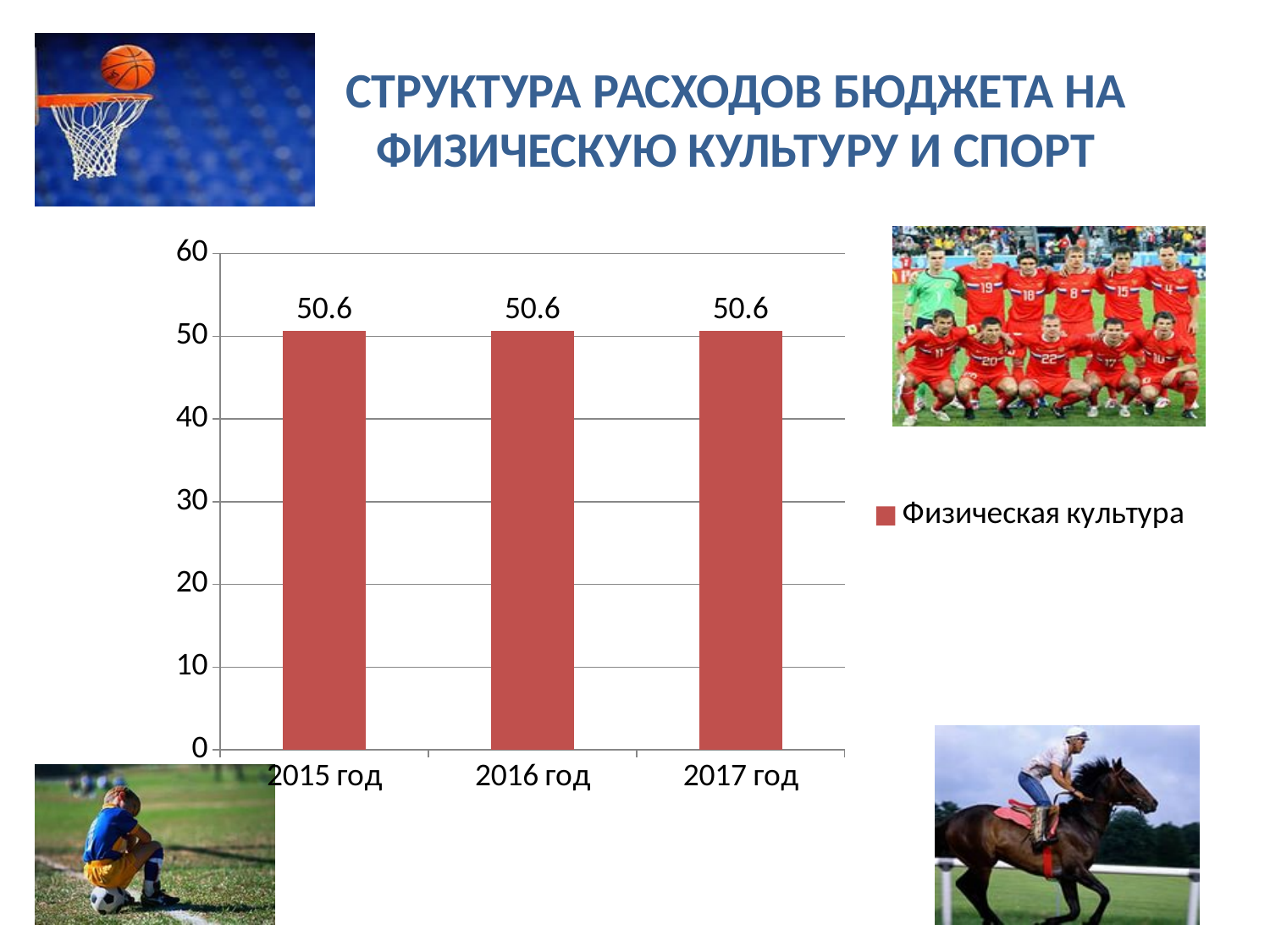
How many categories are shown on the x axis? 3 Is the value for 2016 год greater or less than 40? greater Is the value for 2017 год greater or less than 60? less What is the value for 2015 год? 50.6 What is the highest value shown on the vertical axis? 60 Do the values rise, fall or stay the same from 2015 год to 2017 год? stay the same What is the difference between the values for 2015 год and 2017 год? 0 What kind of chart is shown on the slide? bar chart What series name is listed in the legend? Физическая культура How many series does the legend list? 1 What is the value for 2017 год? 50.6 What is the value for 2016 год? 50.6